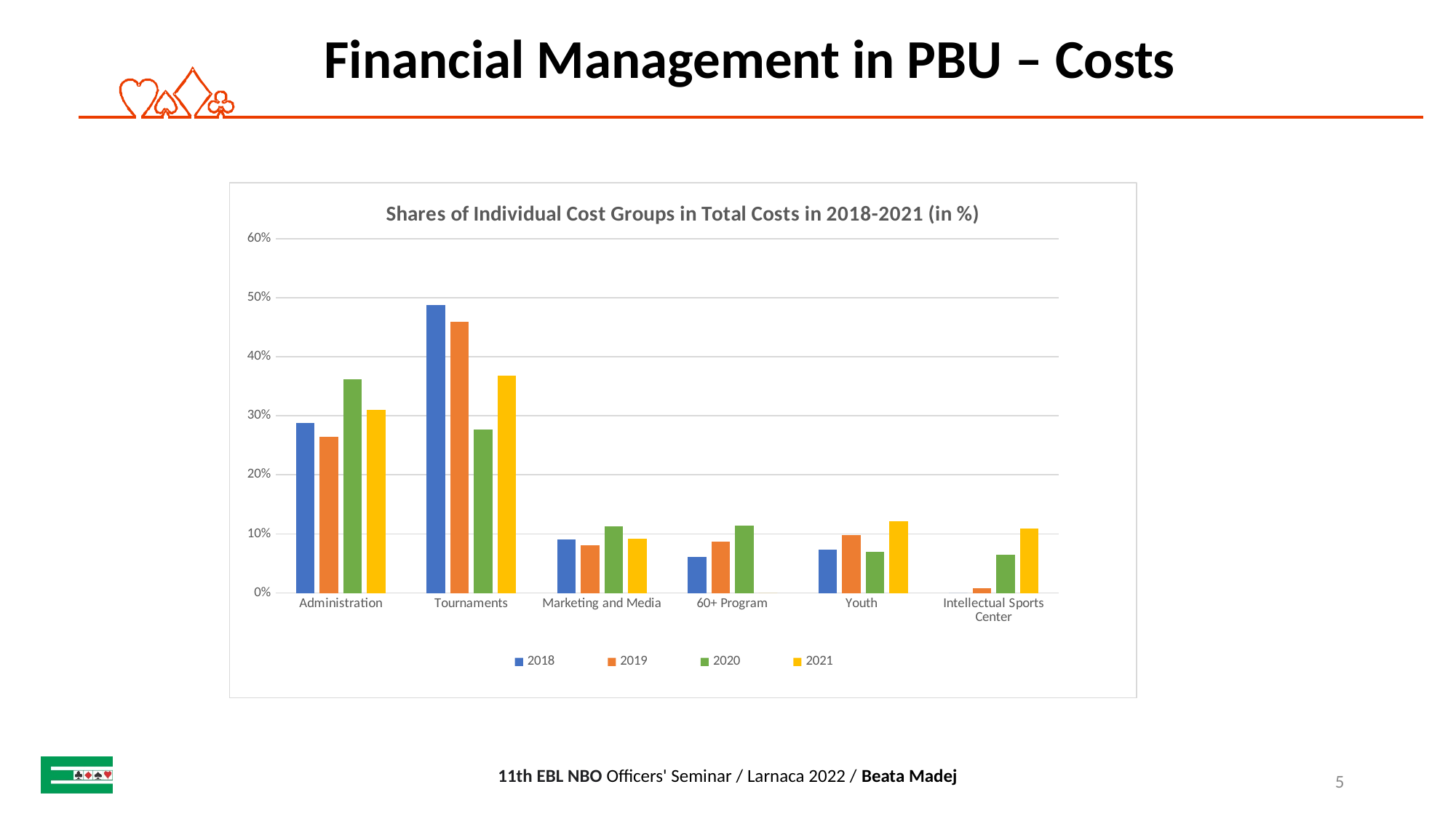
How many series does the legend list? 4 Is the value for Administration in 2020 greater or less than 30%? greater Is the value for Tournaments in 2018 greater or less than 40%? greater How many cost group categories are shown on the x axis? 6 Does the share for Intellectual Sports Center rise or fall from 2019 to 2021? rise Which cost group has the highest share in 2018? Tournaments What is the title of the chart? Shares of Individual Cost Groups in Total Costs in 2018-2021 (in %) For Tournaments, which year has the larger share: 2018 or 2020? 2018 Which cost group has the lowest share in 2019? Intellectual Sports Center For Administration, which year has the larger share: 2019 or 2020? 2020 Is the value for Marketing and Media in 2019 greater or less than 10%? less What kind of chart is shown on the slide? bar chart